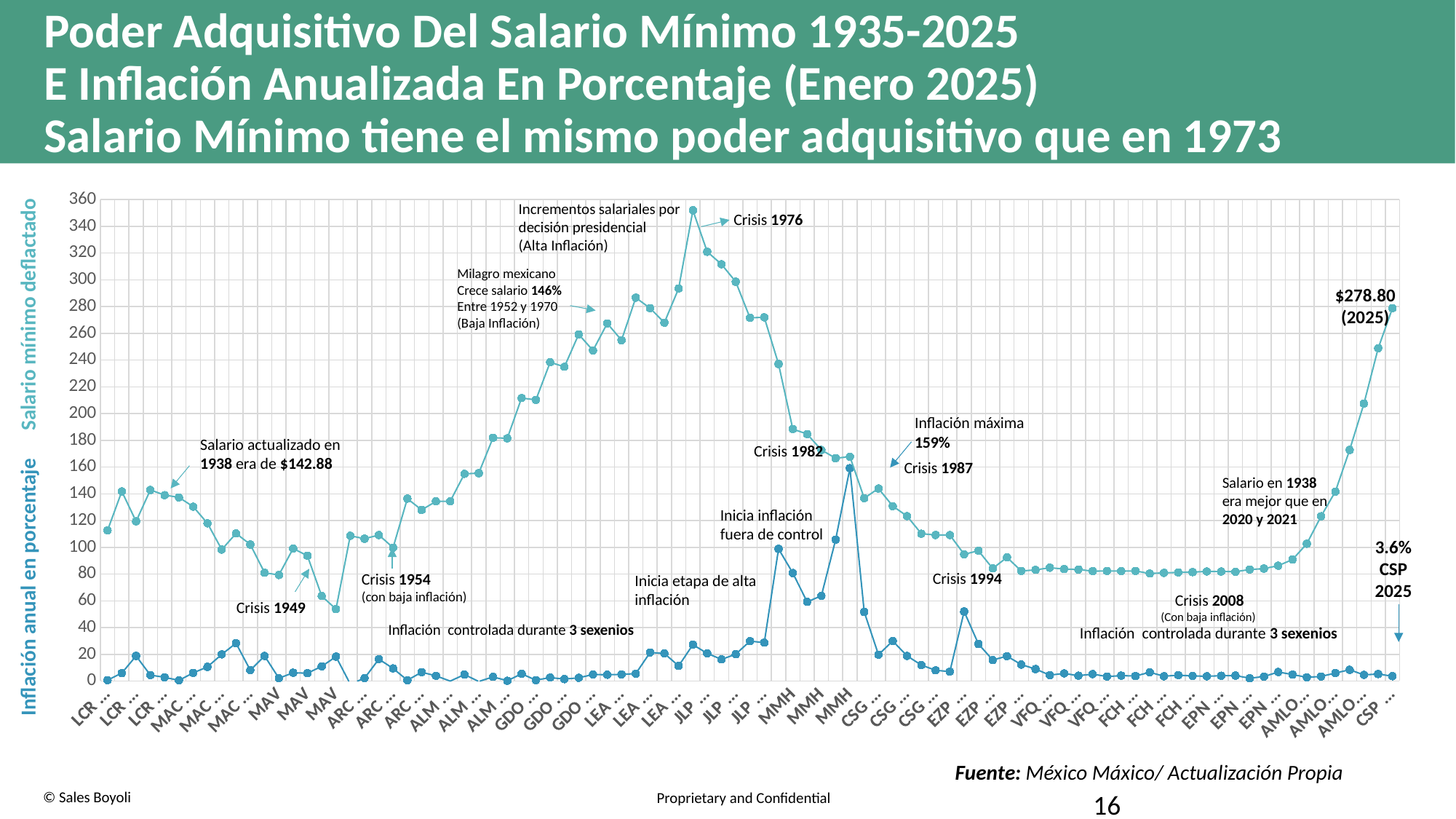
Is the deflated minimum wage in 2025 higher or lower than in 1938? higher Is the deflated minimum wage at the 1976 peak greater or less than 340? greater What is the maximum inflation value annotated on the chart? 159% Does the deflated minimum wage line rise or fall between the 1976 peak and the 1987 crisis? fall What is the difference between the 2025 deflated minimum wage ($278.80) and the 1938 value ($142.88)? $135.92 What annual inflation percentage is labelled for CSP 2025? 3.6% According to the annotation, what was the updated minimum wage in 1938? $142.88 What kind of chart is shown on the slide? line chart How many data series are plotted on the chart? 2 What is the deflated minimum wage value labelled for 2025? $278.80 What source is cited below the chart? México Máxico/ Actualización Propia Which crisis year is annotated at the highest point of the deflated minimum wage line? 1976